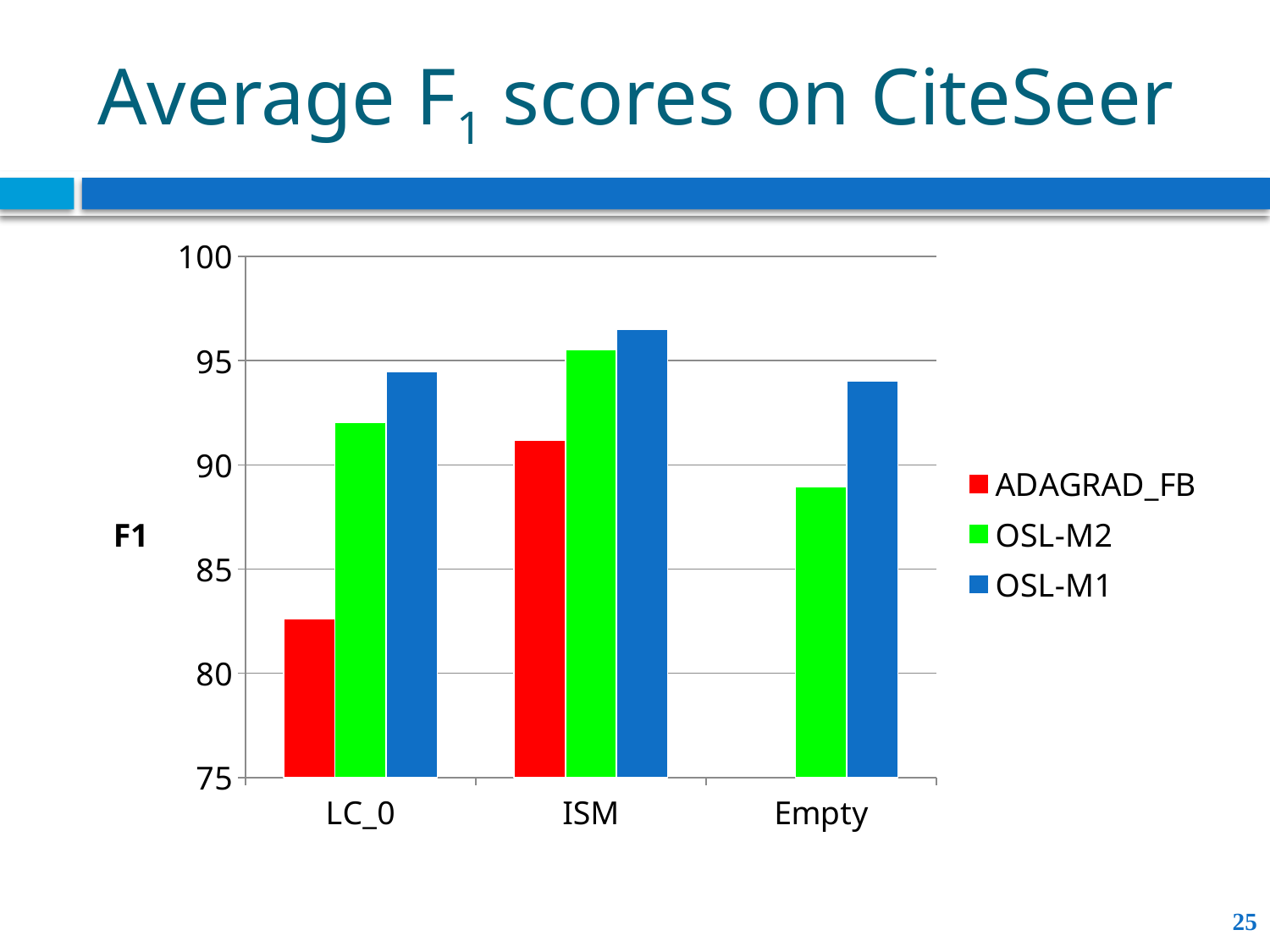
Which series has the lowest value at LC_0? ADAGRAD_FB Is the value for ADAGRAD_FB at ISM greater or less than 90? greater Is the value for OSL-M1 at ISM greater or less than 95? greater At LC_0, which is larger: OSL-M1 or OSL-M2? OSL-M1 How many series does the legend list? 3 Is the value for ADAGRAD_FB at LC_0 greater or less than 85? less How many categories are shown on the x axis? 3 In which category does OSL-M1 reach its highest value? ISM What kind of chart is shown on the slide? bar chart For ADAGRAD_FB, which category has the larger value: LC_0 or ISM? ISM